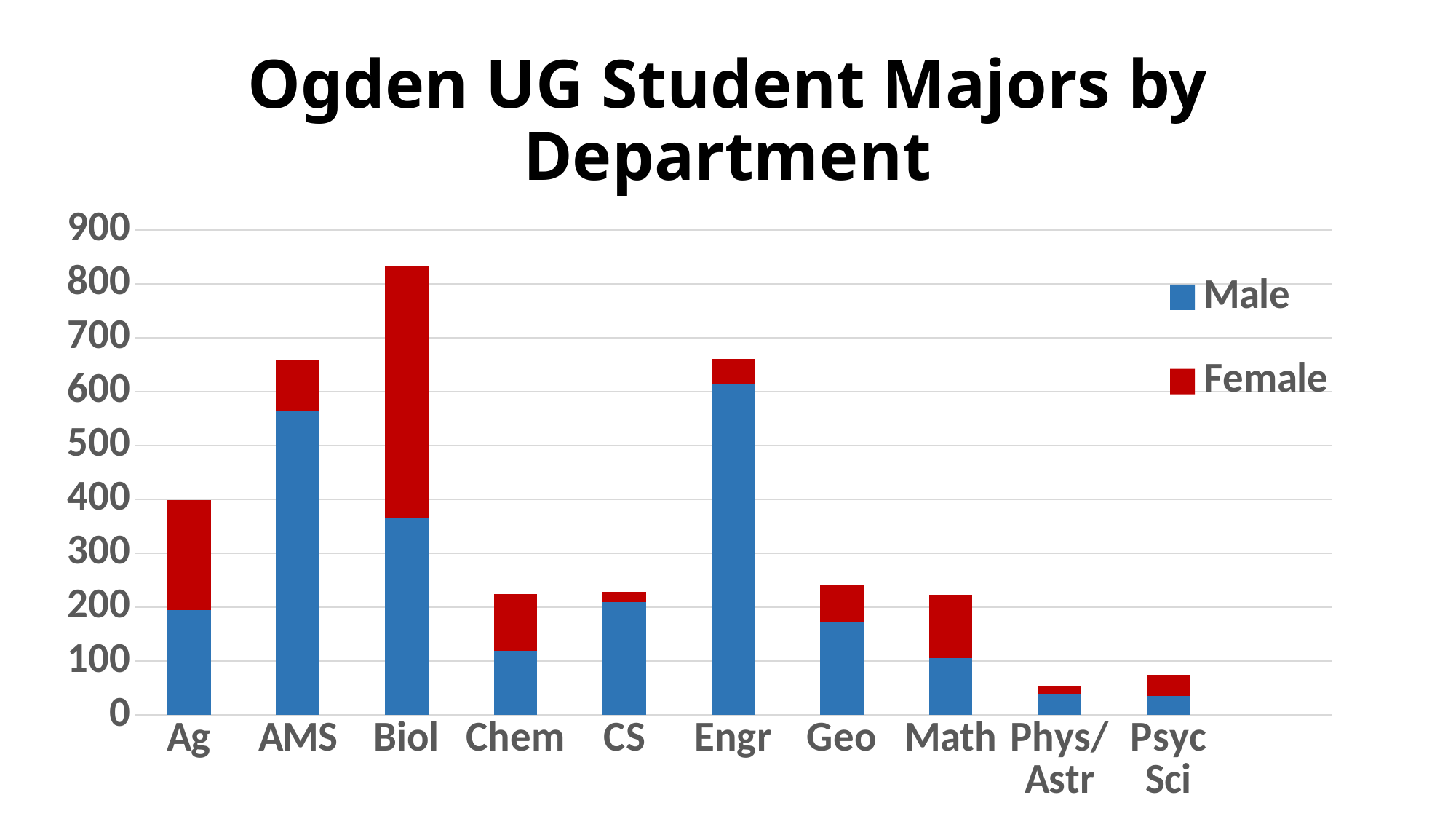
Which has a larger total, Ag or Geo? Ag What kind of chart is shown on the slide? Stacked bar chart Which department has the lowest total number of majors? Phys/Astr Which department has the highest total number of majors? Biol Which department has the largest Male segment? Engr How many series does the legend list? 2 Is the Male value for Engr greater or less than 600? greater Which department has the largest Female segment? Biol Is the total value for Biol greater or less than 800? greater What is the title of the chart? Ogden UG Student Majors by Department Is the total value for Phys/Astr greater or less than 100? less How many departments are shown on the x axis? 10